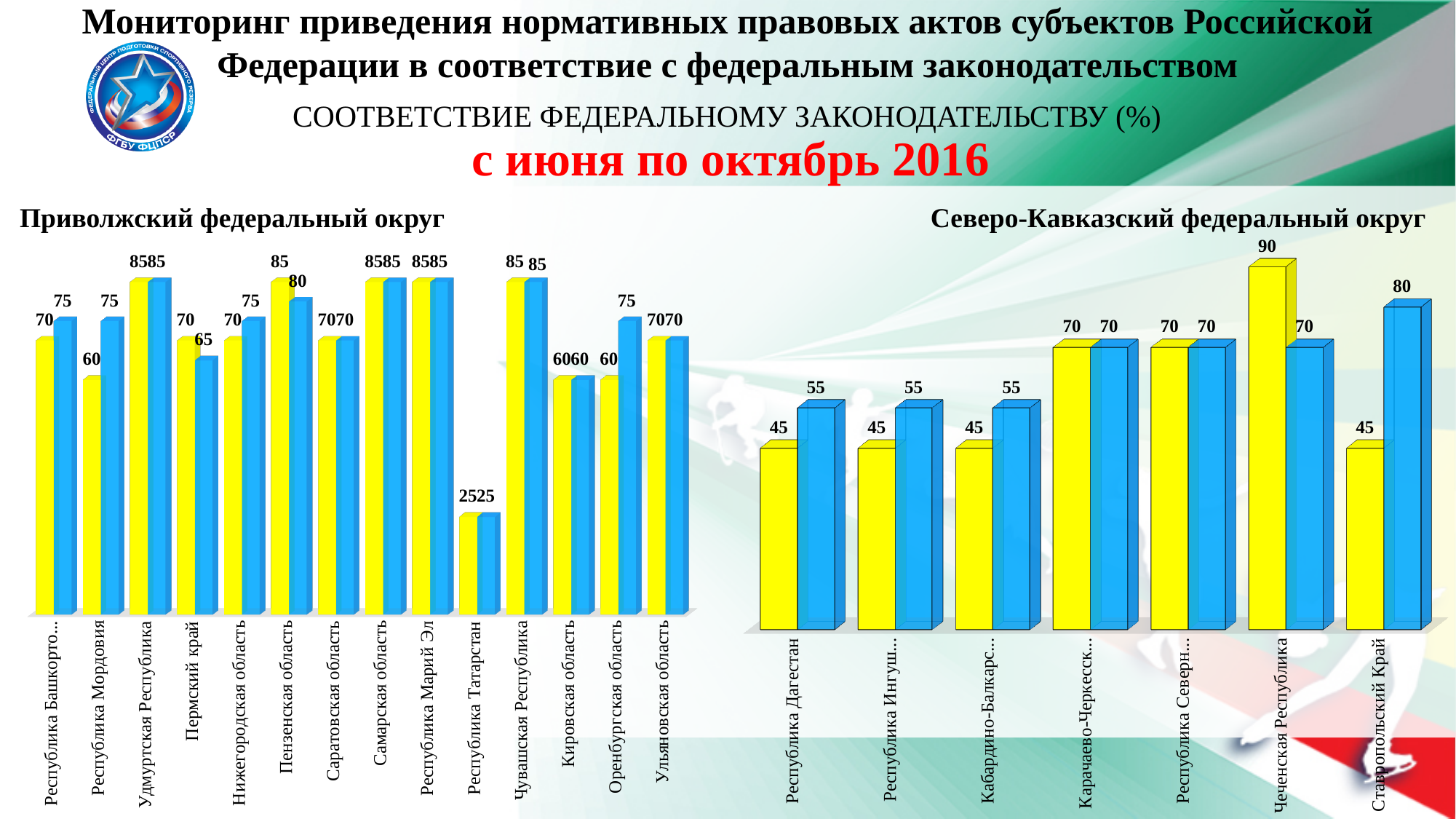
On the Северо-Кавказский федеральный округ chart, what is the value of the yellow bar for Чеченская Республика? 90 On the Приволжский федеральный округ chart, what is the value of the blue bar for Пермский край? 65 On the Северо-Кавказский федеральный округ chart, which is larger for Республика Дагестан: the yellow bar or the blue bar? the blue bar On the Северо-Кавказский федеральный округ chart, what is the value of the blue bar for Ставропольский край? 80 What type of chart is used on the slide? bar chart On the Приволжский федеральный округ chart, what is the difference between the blue bar and the yellow bar for Республика Мордовия? 15 On the Приволжский федеральный округ chart, how many categories are shown on the x axis? 14 On the Северо-Кавказский федеральный округ chart, which category has the highest yellow bar? Чеченская Республика On the Приволжский федеральный округ chart, what is the value of the yellow bar for Республика Татарстан? 25 On the Приволжский федеральный округ chart, which category has the lowest values? Республика Татарстан On the Северо-Кавказский федеральный округ chart, how many categories are shown on the x axis? 7 On the Северо-Кавказский федеральный округ chart, what is the difference between the blue bar and the yellow bar for Ставропольский край? 35